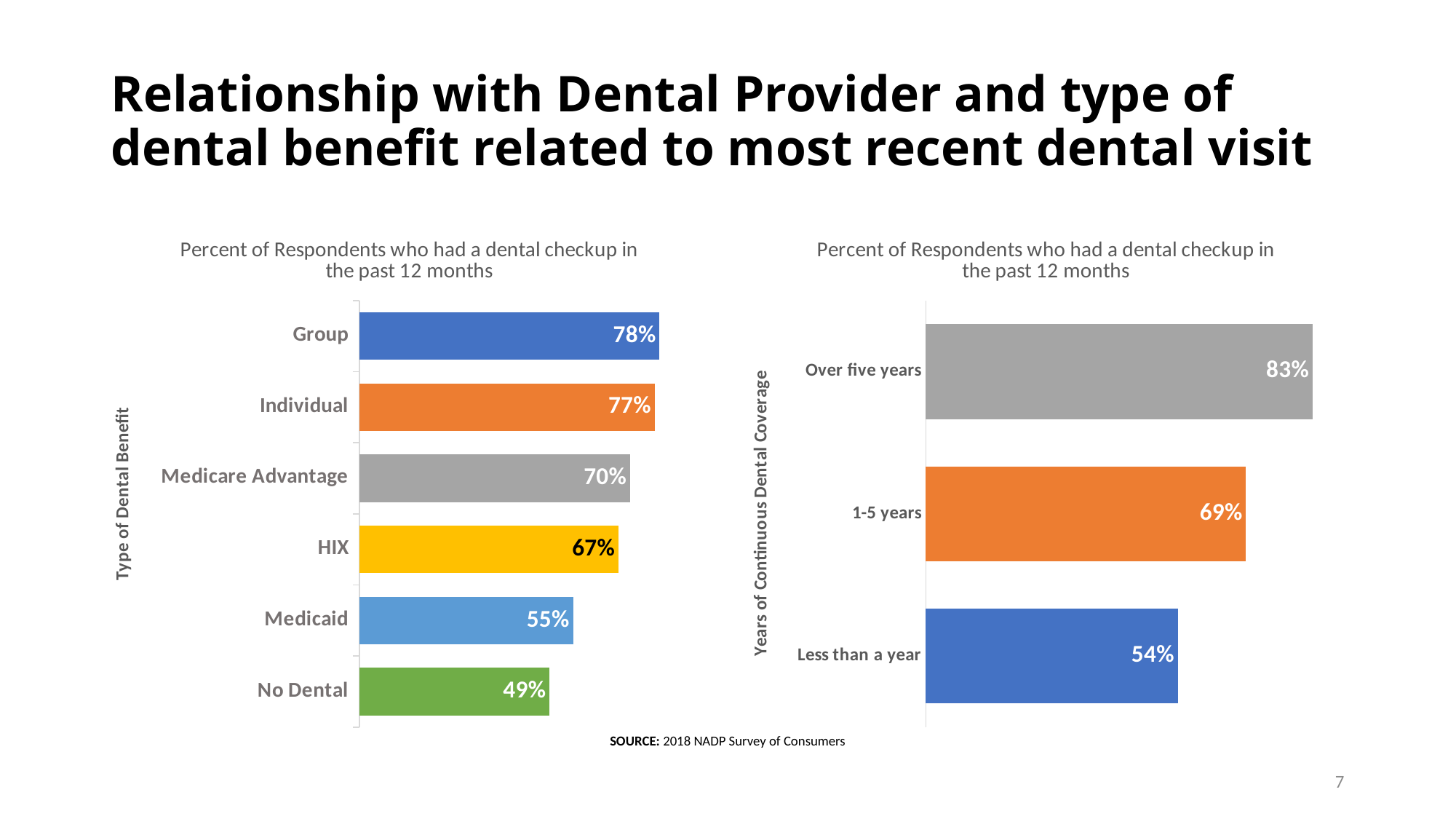
In the right chart (Years of Continuous Dental Coverage), what is the difference between Over five years and Less than a year? 29% In the right chart (Years of Continuous Dental Coverage), which category has the highest value? Over five years In the left chart (Type of Dental Benefit), what is the difference between the Group and No Dental values? 29% What is the y-axis label of the left chart? Type of Dental Benefit In the right chart (Years of Continuous Dental Coverage), what is the value for 1-5 years? 69% How many categories are shown in the right chart (Years of Continuous Dental Coverage)? 3 In the left chart (Type of Dental Benefit), what is the value for Medicaid? 55% In the left chart (Type of Dental Benefit), which type of dental benefit has the lowest percent of respondents with a checkup? No Dental In the left chart (Type of Dental Benefit), what percent of Group respondents had a dental checkup in the past 12 months? 78% In the left chart (Type of Dental Benefit), which is larger, the value for Medicare Advantage or the value for HIX? Medicare Advantage How many types of dental benefit are shown in the left chart? 6 What kind of chart is the right chart (Years of Continuous Dental Coverage)? Bar chart